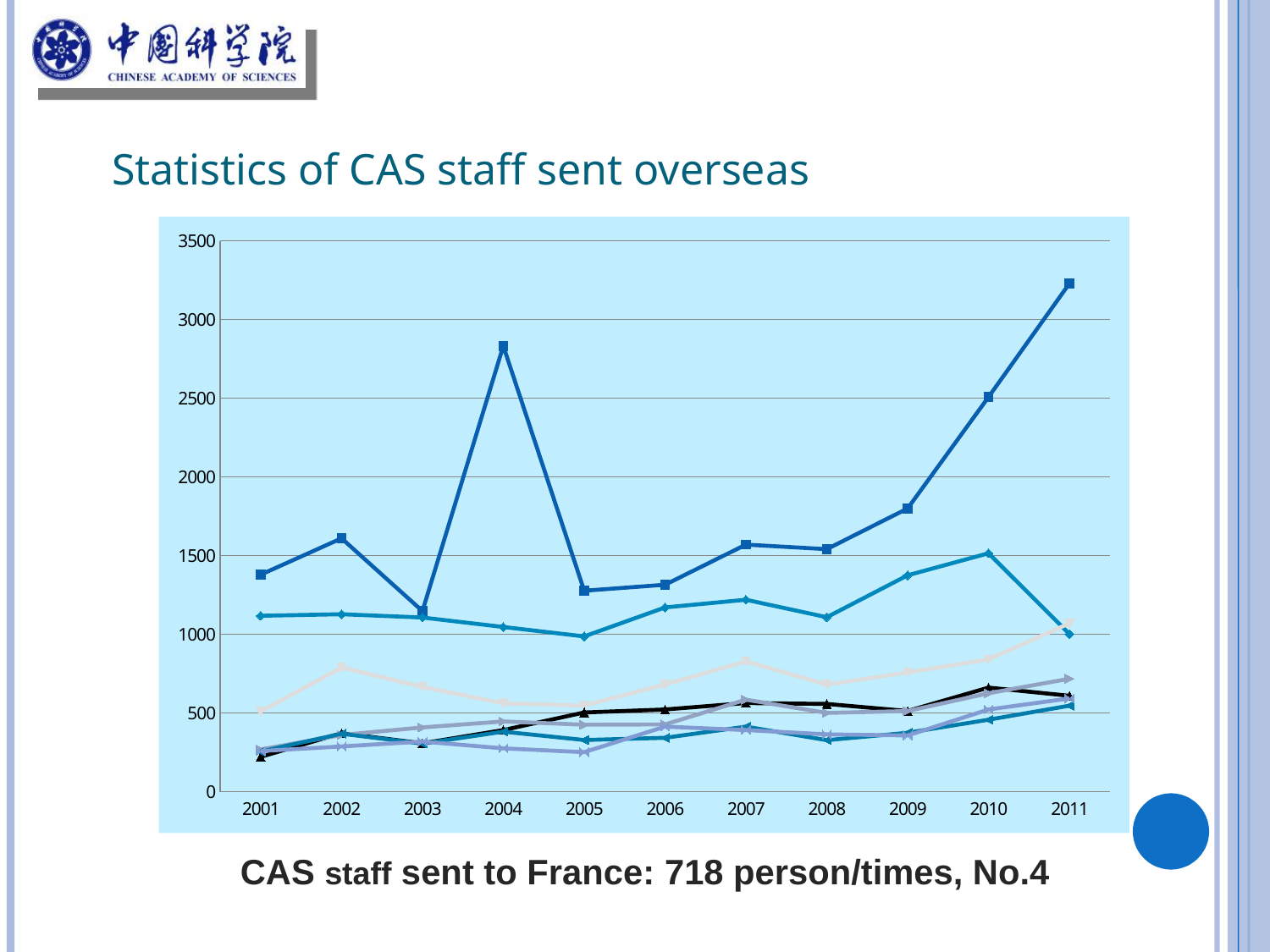
How many years are shown along the x axis of the chart? 11 Is the lowest value plotted for 2001 greater or less than 500? less What is the last year shown on the x axis? 2011 Does the topmost line rise or fall between 2009 and 2011? rise According to the caption below the chart, how many person/times of CAS staff were sent to France? 718 person/times What is the title of the slide containing the chart? Statistics of CAS staff sent overseas In which year does the topmost line reach its highest value? 2011 What kind of chart is shown on the slide? line chart Is the highest value plotted for 2011 greater or less than 3000? greater What is the first year shown on the x axis? 2001 What is the maximum value shown on the y axis? 3500 Is the highest value plotted for 2004 greater or less than 2500? greater